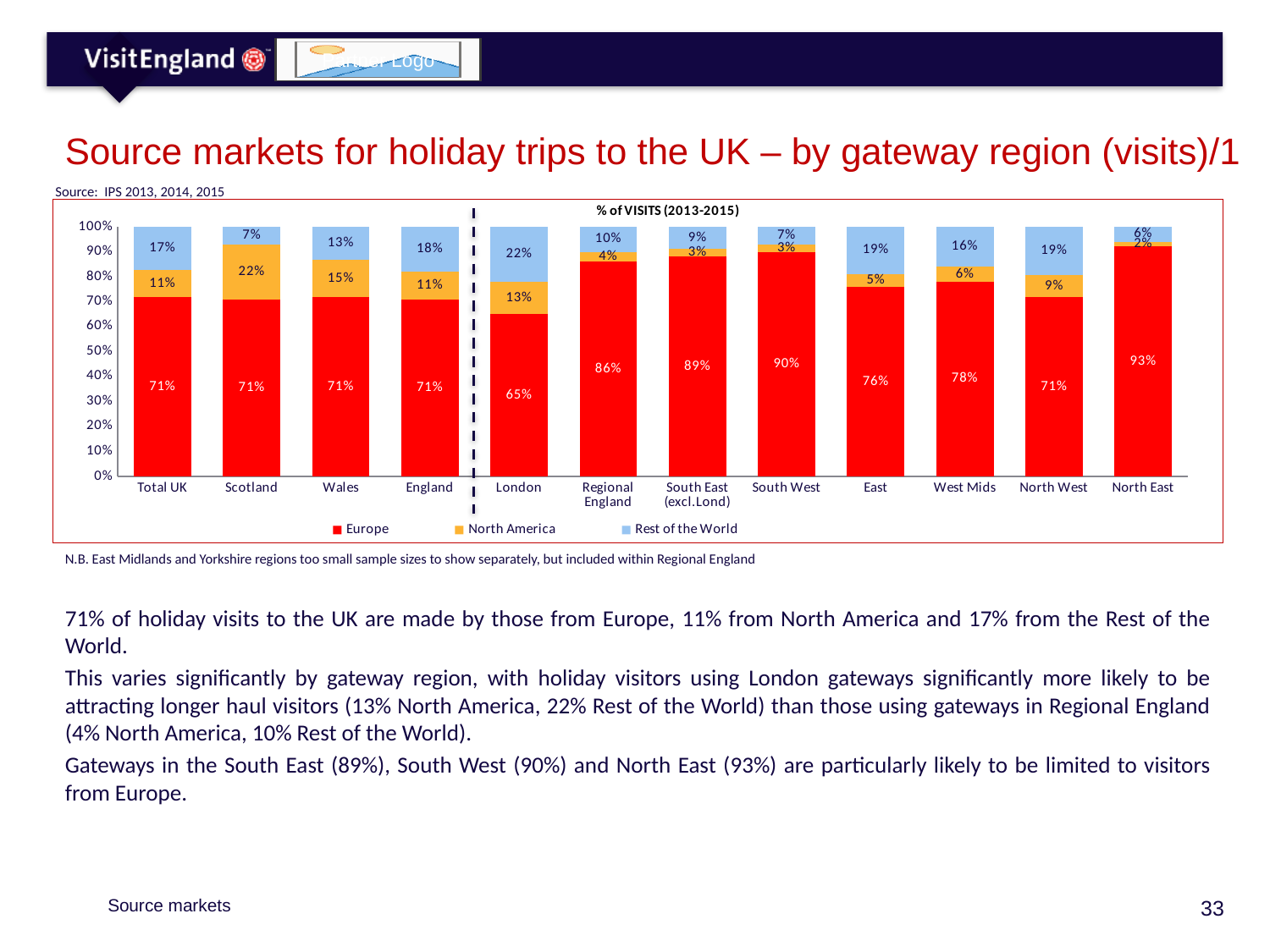
How many gateway regions (categories) are shown on the x axis? 12 Which gateway region has the lowest Europe share? London What percentage of holiday visits via London gateways come from the Rest of the World? 22% What is the North America share for Scotland? 22% What is the title printed above the chart? % of VISITS (2013-2015) Which gateway region has the highest Europe share? North East What type of chart is shown? Stacked bar chart How many series does the legend list? 3 What is the difference between the Europe share for North East and the Europe share for London? 28 percentage points Which is larger: the Rest of the World share for East or for West Mids? East What is the North America share for North East? 2% What is the Europe share for Regional England? 86%